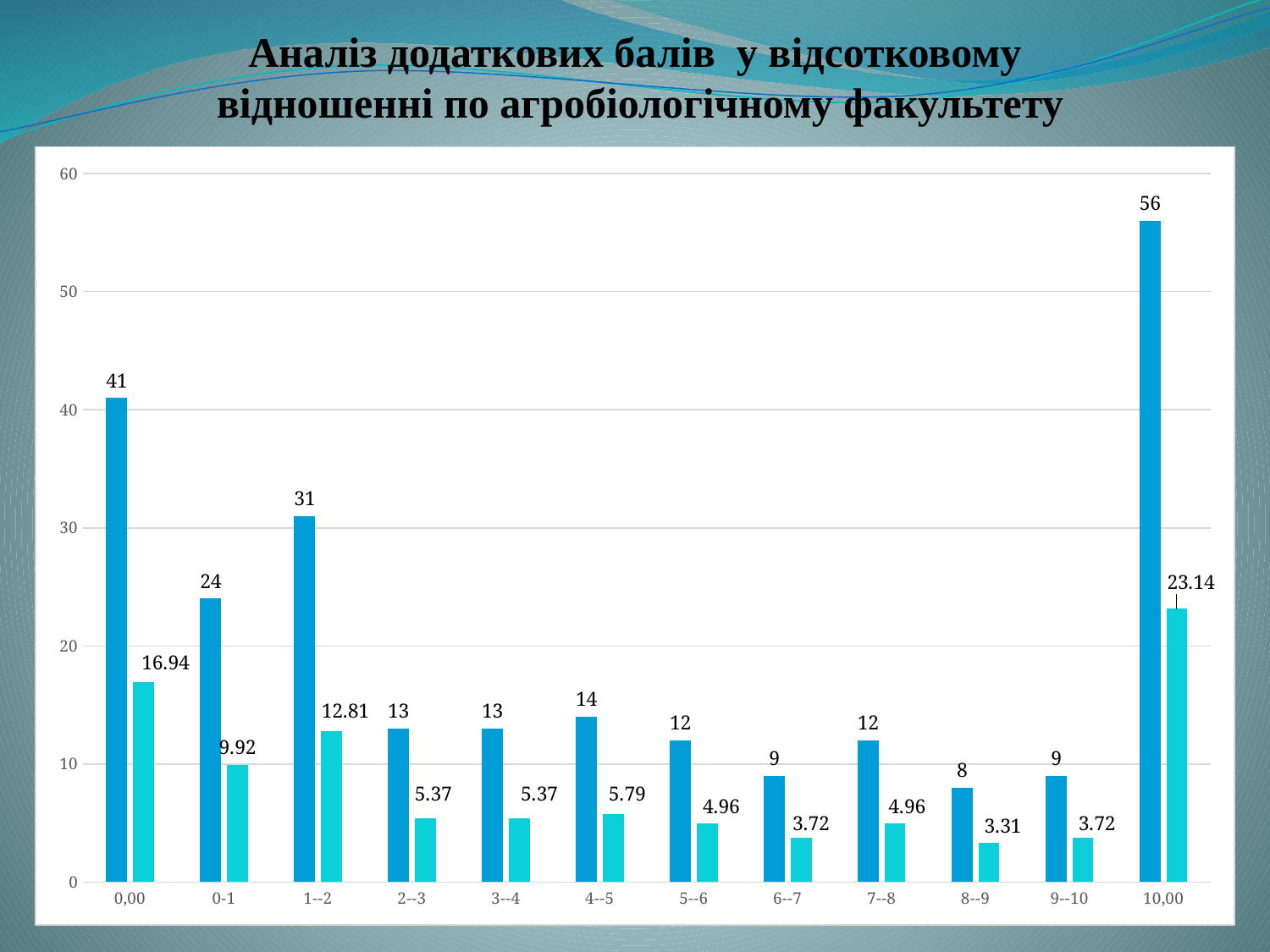
What is the difference between the dark blue bars for 10,00 and 0,00? 15 What is the title of the slide? Аналіз додаткових балів у відсотковому відношенні по агробіологічному факультету What is the value of the light cyan bar for the category 10,00? 23.14 Is the dark blue bar for 10,00 greater or less than 50? greater What is the difference between the light cyan bars for 0,00 and 0-1? 7.02 What is the value of the light cyan bar for the category 1--2? 12.81 Which is larger, the dark blue bar for 0-1 or the dark blue bar for 1--2? 1--2 What type of chart is shown on the slide? bar chart Which category has the lowest light cyan bar? 8--9 What is the value of the dark blue bar for the category 0,00? 41 How many categories are shown on the x axis? 12 Which category has the highest dark blue bar? 10,00